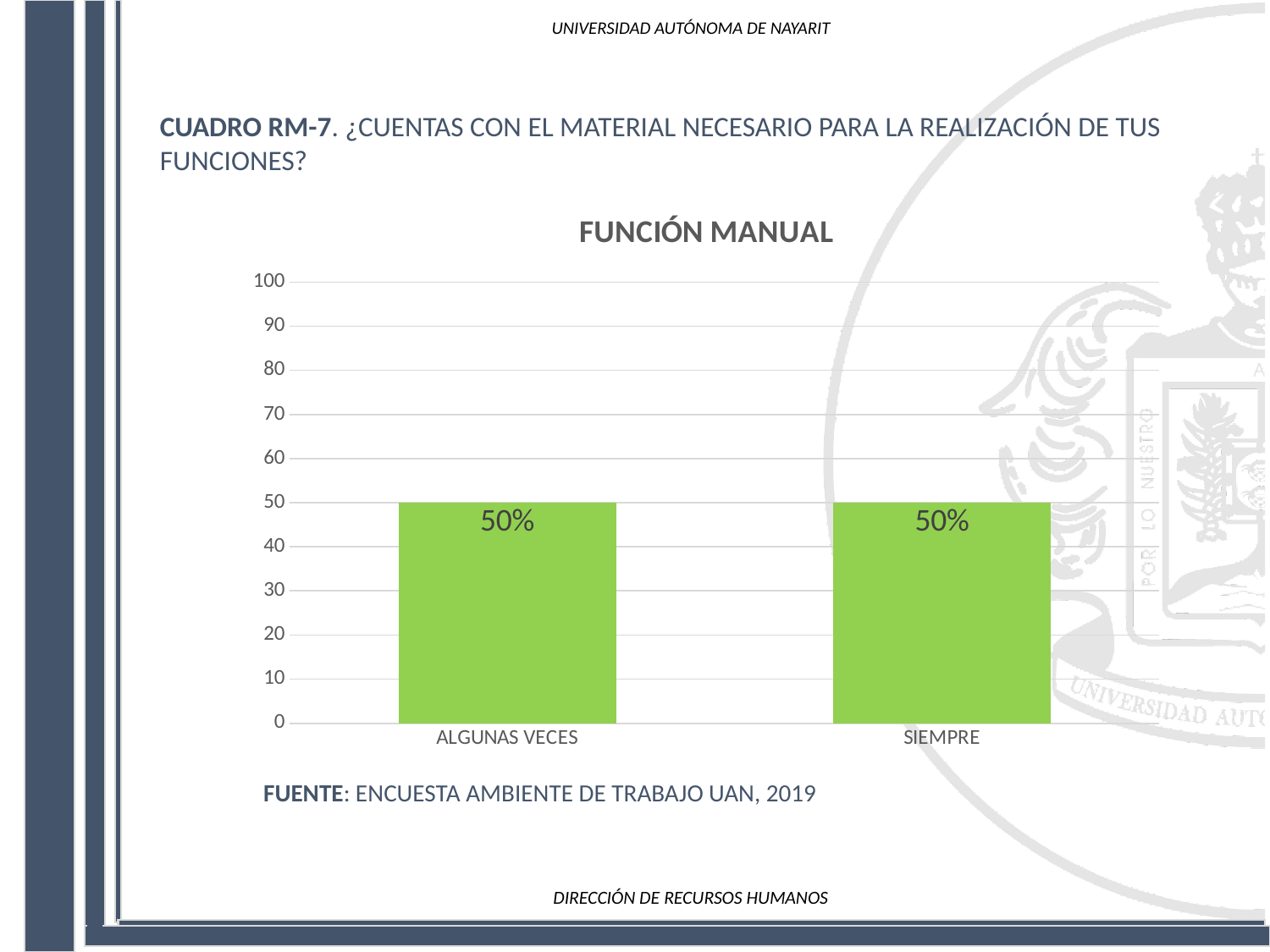
Is the value for SIEMPRE greater or less than 70? less What is the value for ALGUNAS VECES? 50% What is the highest value shown on the y axis? 100 How many categories are shown on the x axis? 2 What is the total of the values for ALGUNAS VECES and SIEMPRE? 100% Is the value for ALGUNAS VECES greater or less than 30? greater What colour are the bars in the chart? green What is the value for SIEMPRE? 50% What kind of chart is shown on the slide? bar chart What is the title of the chart? FUNCIÓN MANUAL What is the difference between the values for ALGUNAS VECES and SIEMPRE? 0